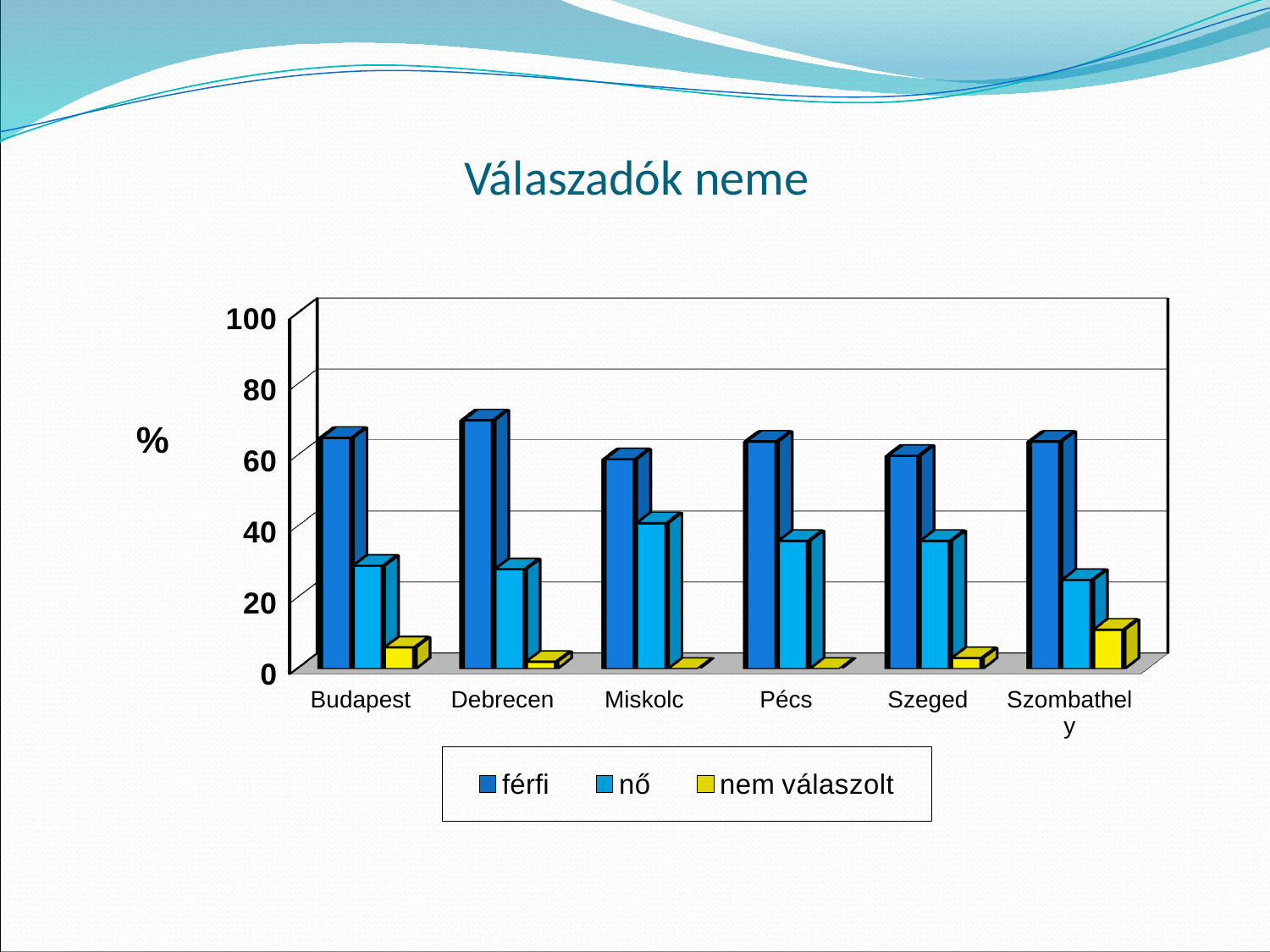
Is the value for férfi in Debrecen greater or less than 60? greater Is the value for nő in Miskolc greater or less than 60? less Which city has the lowest value for nő? Szombathely Which city has the highest value for nem válaszolt? Szombathely What kind of chart is shown on the slide? bar chart How many series does the legend list? 3 Is the value for nem válaszolt in Szombathely greater or less than 20? less Which city has the highest value for nő? Miskolc Which city has the highest value for férfi? Debrecen How many cities are shown on the x axis of the chart? 6 In Budapest, which is larger: the value for férfi or the value for nő? férfi What is the title of the chart? Válaszadók neme